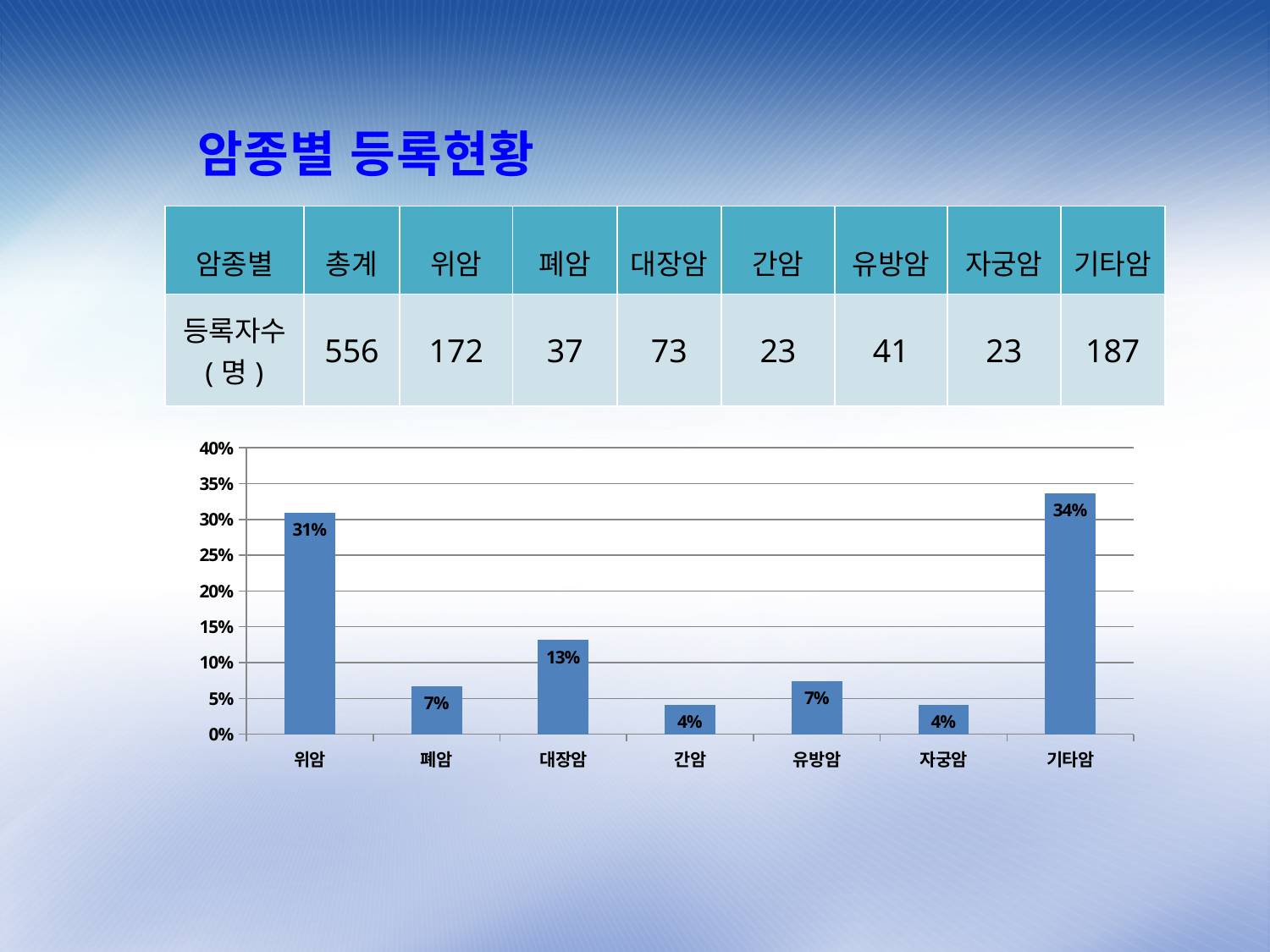
What is the difference in percentage points between 기타암 and 위암? 3 percentage points How many categories are shown on the x axis of the chart? 7 What is the highest value shown on the chart's y axis? 40% What percentage is shown for 자궁암 in the chart? 4% What percentage is shown for 유방암 in the chart? 7% Which is larger in the chart, the value for 대장암 or the value for 폐암? 대장암 What percentage is shown for 대장암 in the chart? 13% Which category has the highest percentage in the chart? 기타암 What kind of chart is shown on the slide? bar chart What percentage is shown for 위암 in the chart? 31% Is the value for 기타암 greater or less than 30%? greater What is the difference in percentage points between 대장암 and 폐암? 6 percentage points